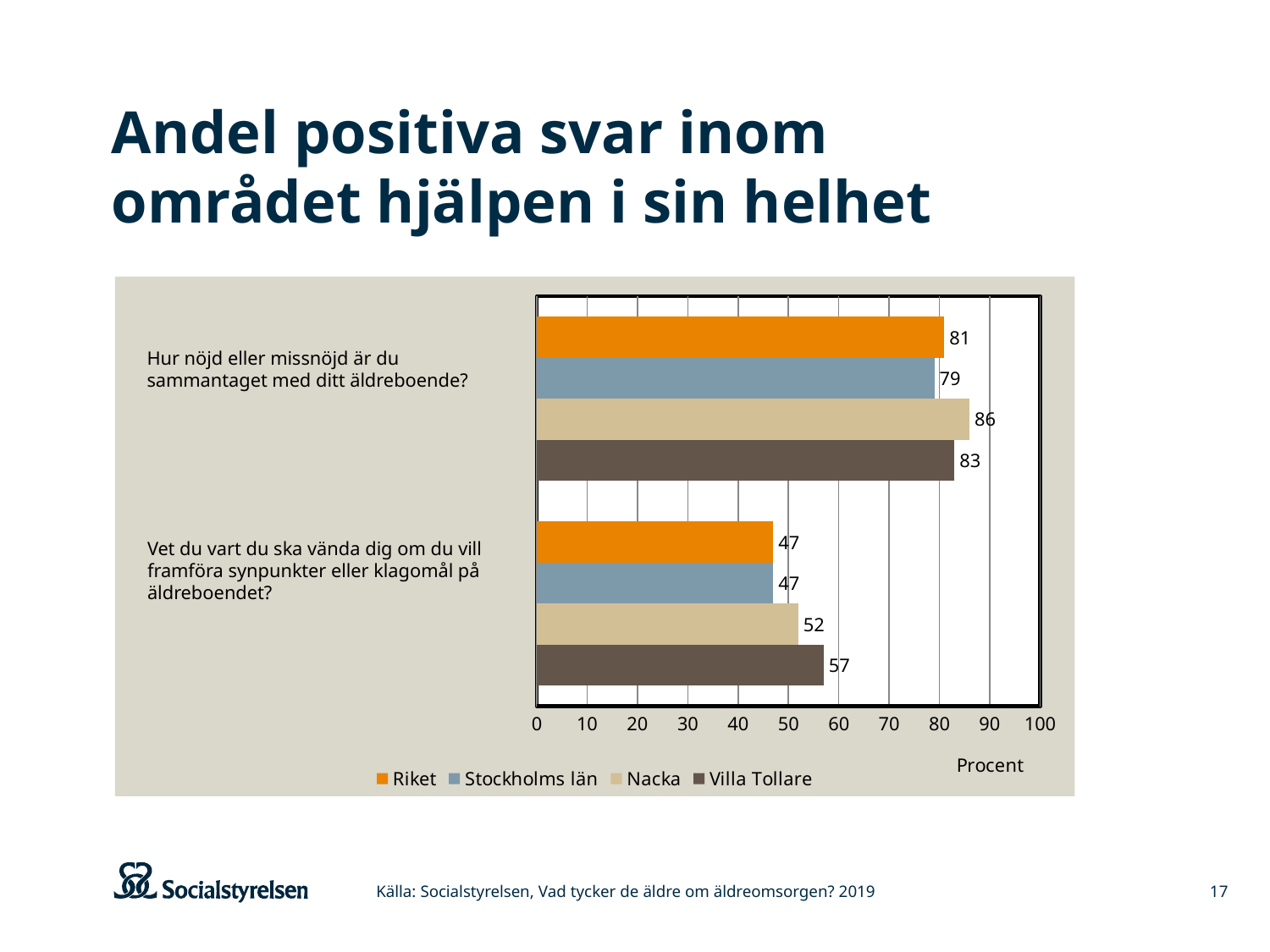
Which series has the highest value on the question "Vet du vart du ska vända dig om du vill framföra synpunkter eller klagomål på äldreboendet?"? Villa Tollare Which series has the lowest value on the question "Hur nöjd eller missnöjd är du sammantaget med ditt äldreboende?"? Stockholms län How many series does the legend list? 4 What kind of chart is shown on the slide? Bar chart What is the difference between Villa Tollare and Riket on the question "Vet du vart du ska vända dig om du vill framföra synpunkter eller klagomål på äldreboendet?"? 10 What is the value for Nacka on the question "Hur nöjd eller missnöjd är du sammantaget med ditt äldreboende?"? 86 What unit label is shown on the horizontal axis of the chart? Procent What is the value for Riket on the question "Hur nöjd eller missnöjd är du sammantaget med ditt äldreboende?"? 81 Which series has the highest value on the question "Hur nöjd eller missnöjd är du sammantaget med ditt äldreboende?"? Nacka What is the value for Villa Tollare on the question "Vet du vart du ska vända dig om du vill framföra synpunkter eller klagomål på äldreboendet?"? 57 What is the difference between Nacka and Stockholms län on the question "Hur nöjd eller missnöjd är du sammantaget med ditt äldreboende?"? 7 Which is larger on the question "Vet du vart du ska vända dig om du vill framföra synpunkter eller klagomål på äldreboendet?": Nacka or Villa Tollare? Villa Tollare